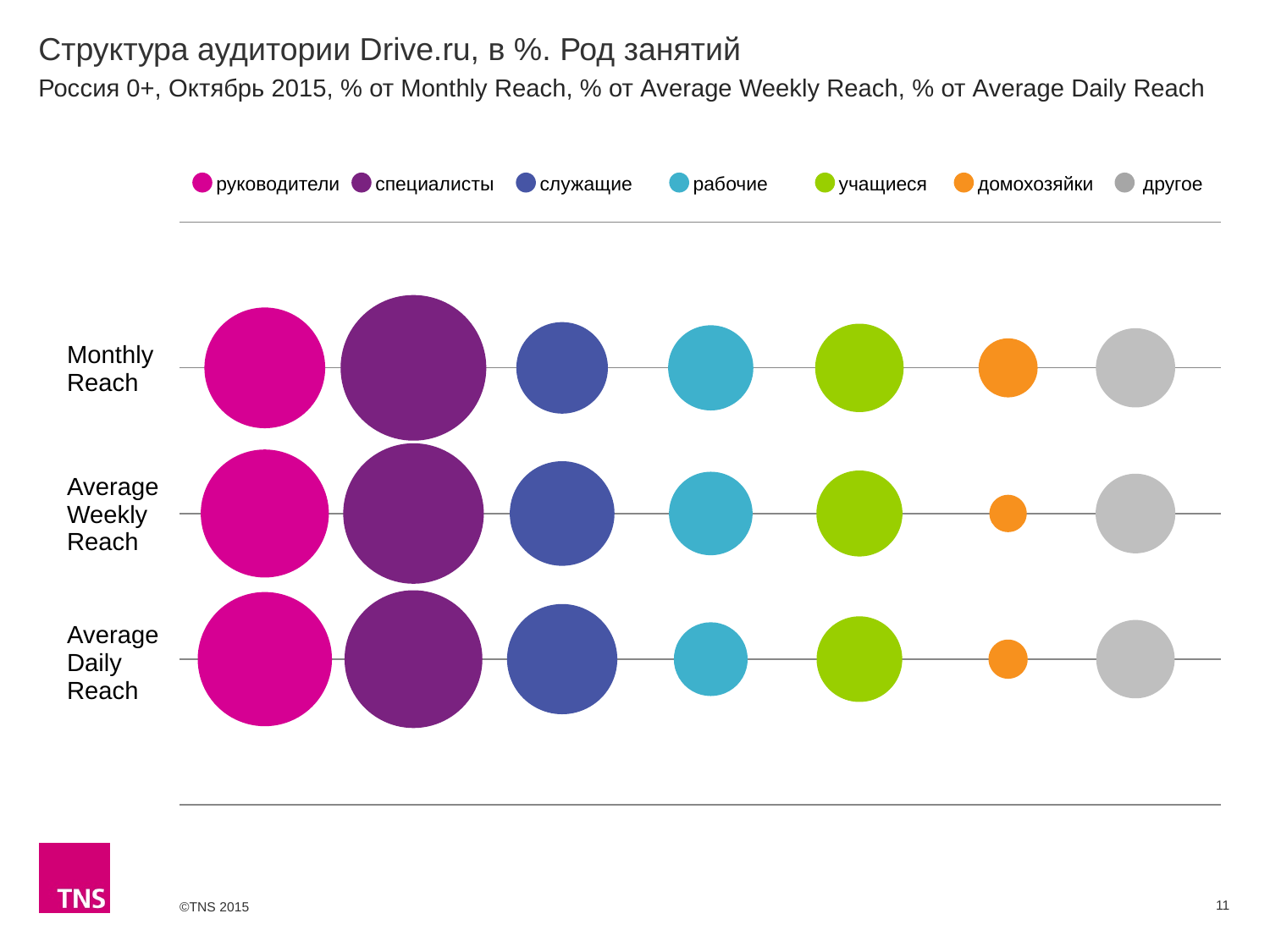
What is the title of the chart on the slide? Структура аудитории Drive.ru, в %. Род занятий Which occupation group has the largest bubble in the Monthly Reach row? специалисты In the Average Daily Reach row, which bubble is larger: рабочие or учащиеся? учащиеся Which occupation group has the smallest bubble in the Average Daily Reach row? домохозяйки What kind of chart is shown on the slide? bubble chart How many reach measures (rows) are plotted on the chart? 3 Does the bubble for домохозяйки get larger or smaller going from Monthly Reach to Average Daily Reach? smaller In the Monthly Reach row, which bubble is larger: специалисты or служащие? специалисты How many occupation groups does the legend list? 7 In the Monthly Reach row, which bubble is larger: домохозяйки or другое? другое Which occupation group has the smallest bubble in the Monthly Reach row? домохозяйки Which occupation group is shown in orange in the legend? домохозяйки